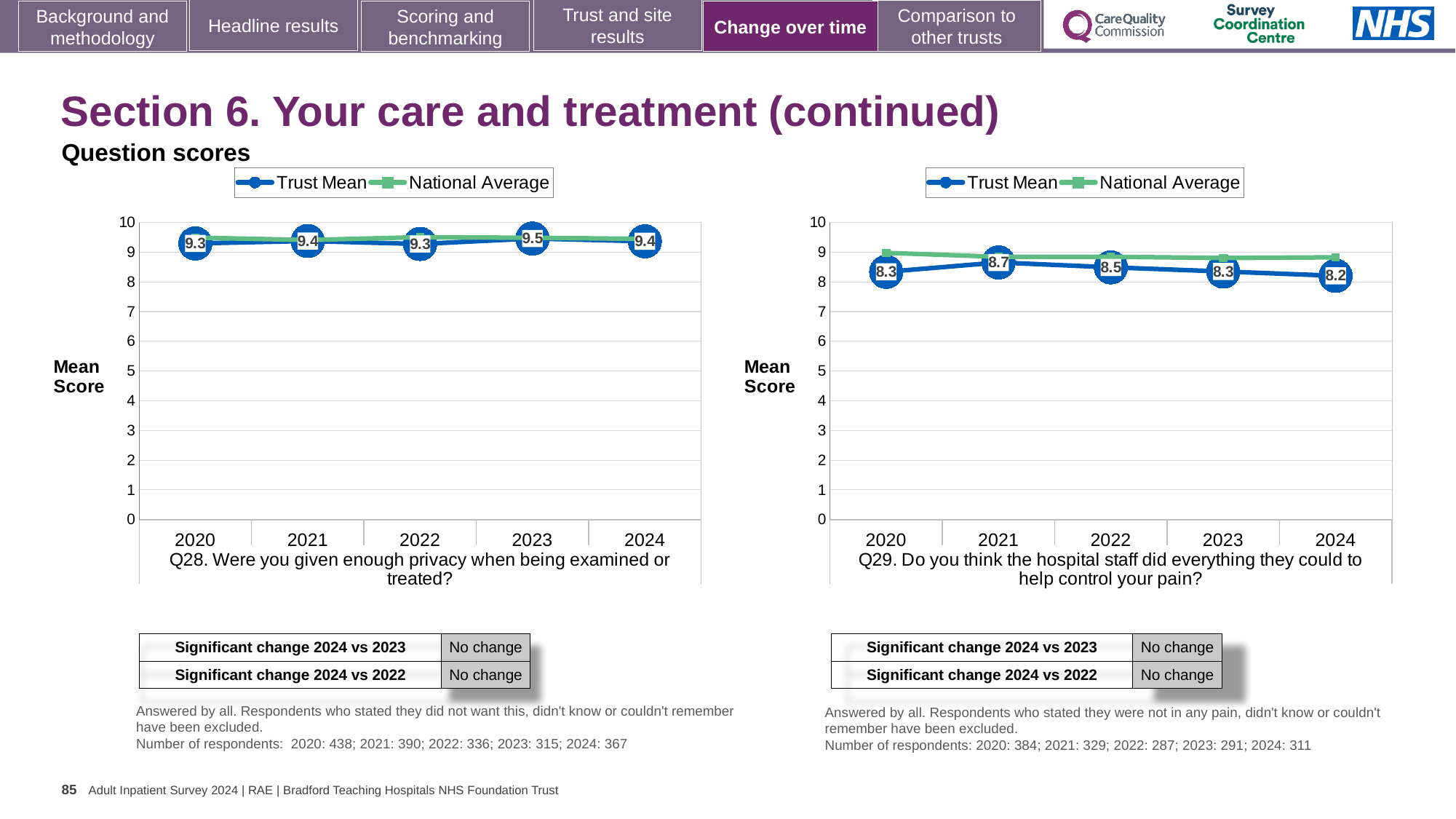
In the Q29 chart (right), is the National Average value for 2020 greater or less than 8? greater In the Q29 chart (right), which year has the lowest Trust Mean score? 2024 In the Q28 chart (left), which year has the highest Trust Mean score? 2023 How many years are shown on the x axis of the Q28 chart (left)? 5 How many series does the legend of the Q29 chart (right) list? 2 What type of chart is used for Q28 (left)? Line chart In the Q29 chart (right), what is the Trust Mean score for 2024? 8.2 In the Q28 chart (left), is the Trust Mean score for 2023 larger than the Trust Mean score for 2022? Yes, 2023 (9.5) is larger than 2022 (9.3) In the Q29 chart (right), what is the difference between the Trust Mean scores for 2021 and 2024? 0.5 In the Q29 chart (right), which year has the highest Trust Mean score? 2021 In the Q29 chart (right), what is the Trust Mean score for 2021? 8.7 In the Q28 chart (left), what is the Trust Mean score for 2023? 9.5